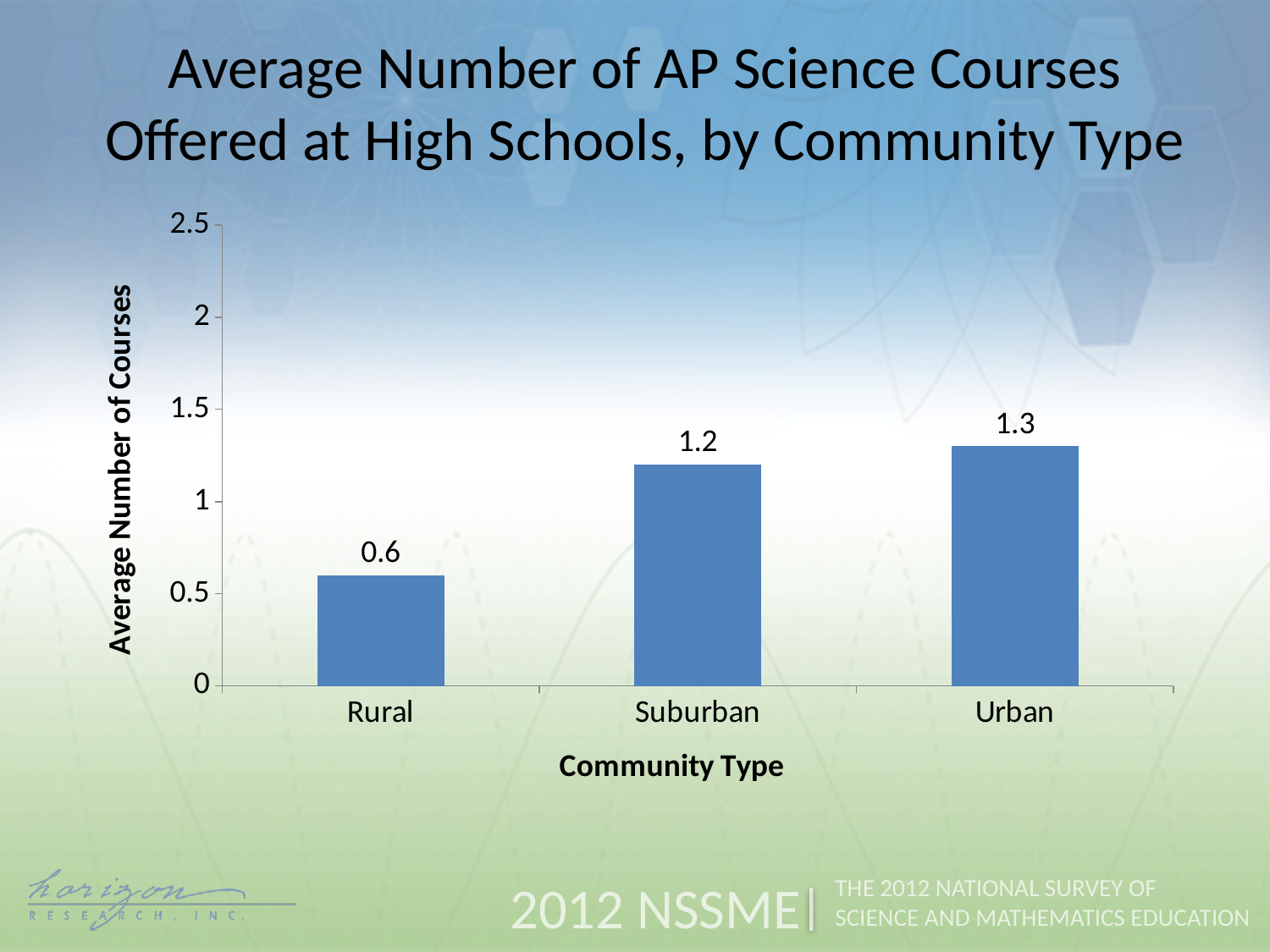
Which community type has the lowest average number of AP science courses? Rural Which has a higher average number of AP science courses, Rural or Suburban? Suburban What is the average number of AP science courses offered at suburban high schools? 1.2 What is the average number of AP science courses offered at urban high schools? 1.3 What is the average number of AP science courses offered at rural high schools? 0.6 What is the difference between the average number of AP science courses at urban and rural high schools? 0.7 What kind of chart is shown on the slide? Bar chart What is the difference between the average number of AP science courses at suburban and rural high schools? 0.6 Which community type has the highest average number of AP science courses? Urban What is the label of the vertical axis? Average Number of Courses How many community types are shown on the chart? 3 Is the value for Rural greater or less than 1? less